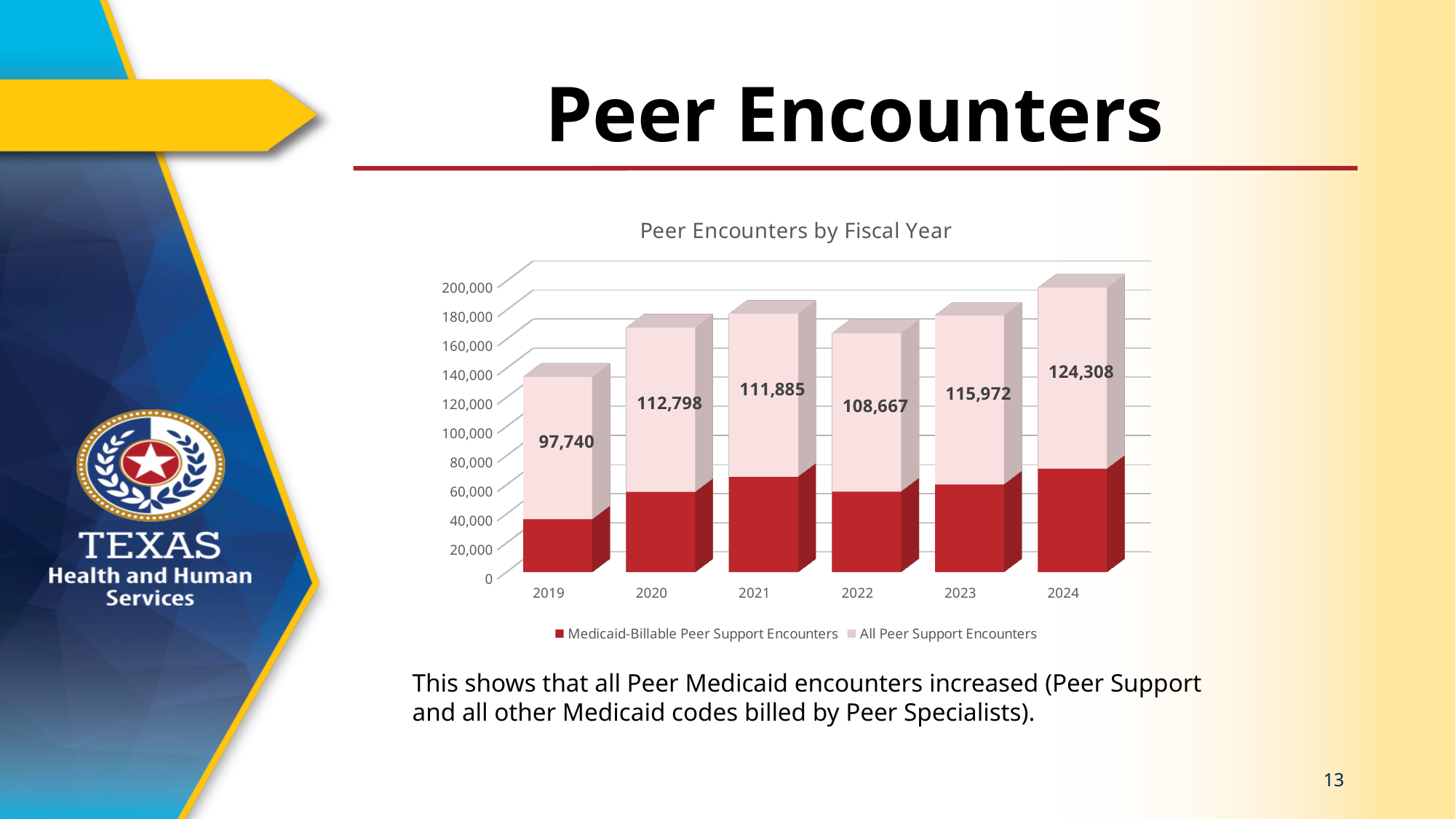
Which fiscal year has the highest labelled value for All Peer Support Encounters? 2024 Is the Medicaid-Billable Peer Support Encounters value for 2019 greater or less than 60,000? less Which fiscal year has the lowest labelled value for All Peer Support Encounters? 2019 Is the Medicaid-Billable Peer Support Encounters value for 2024 greater or less than 60,000? greater How many fiscal years are shown on the x axis? 6 What is the difference between the All Peer Support Encounters values for 2024 and 2019? 26,568 How many series does the legend list? 2 What is the value of All Peer Support Encounters for 2022? 108,667 What is the value of All Peer Support Encounters for 2019? 97,740 What is the value of All Peer Support Encounters for 2024? 124,308 Which year has the larger All Peer Support Encounters value, 2020 or 2021? 2020 What kind of chart is shown on the slide? Stacked bar chart